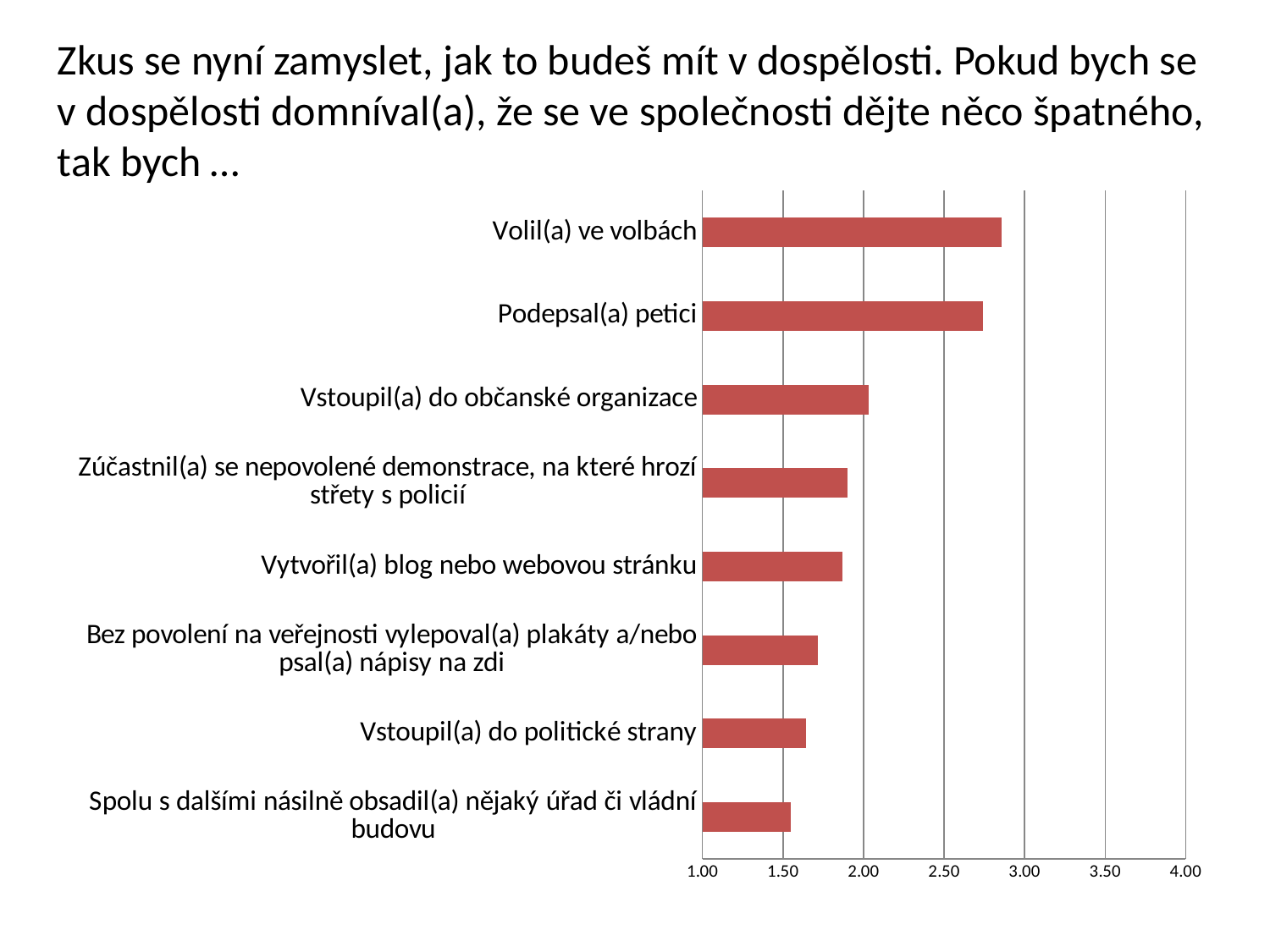
How many categories are plotted in the chart? 8 Is the value for Vstoupil(a) do občanské organizace greater or less than 2.50? less Is the value for Volil(a) ve volbách greater or less than 2.50? greater Is the value for Vytvořil(a) blog nebo webovou stránku greater or less than 2.00? less Which category has the highest value in the chart? Volil(a) ve volbách Which category has the lowest value in the chart? Spolu s dalšími násilně obsadil(a) nějaký úřad či vládní budovu What is the maximum value shown on the horizontal axis of the chart? 4.00 What kind of chart is shown on the slide? bar chart Which has the larger value: Vstoupil(a) do občanské organizace or Vstoupil(a) do politické strany? Vstoupil(a) do občanské organizace